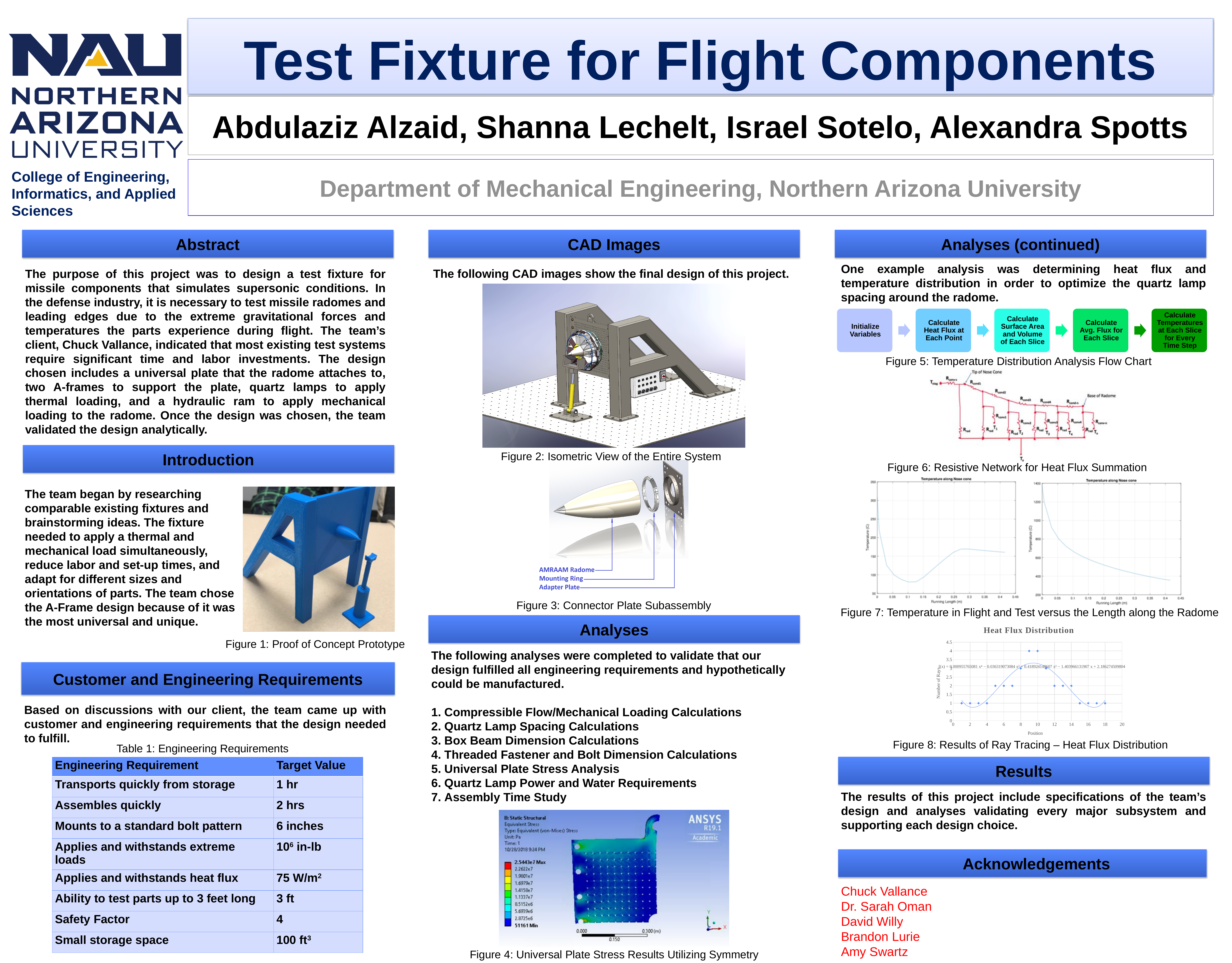
How many separate plots make up Figure 7? 2 What kind of chart is Figure 8 (Heat Flux Distribution)? scatter chart In Figure 8 (Heat Flux Distribution), what is the highest number of rays plotted? 4 In Figure 8 (Heat Flux Distribution), is the number of rays at position 10 greater or less than 3? greater In the right-hand plot of Figure 7, is the temperature at running length 0 greater or less than 1200? greater In the right-hand plot of Figure 7, does the temperature rise or fall as running length increases? fall In Figure 8 (Heat Flux Distribution), what is the highest value shown on the y axis? 4.5 What is the title of the chart in Figure 8? Heat Flux Distribution In the left-hand plot of Figure 7, is the temperature at running length 0.1 greater or less than 150? less